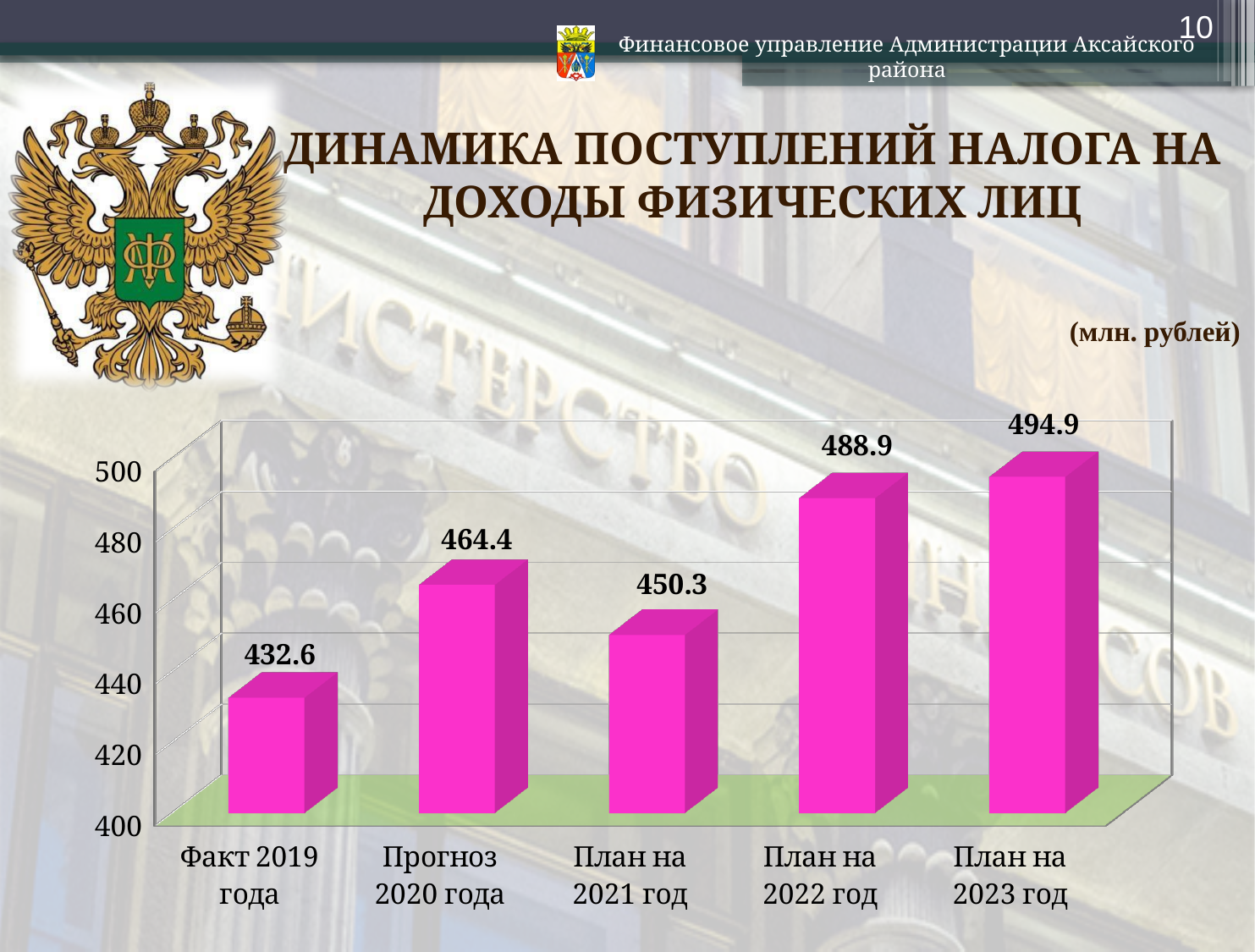
Is the value for План на 2021 год greater or less than 460? less In what units are the chart values given? млн. рублей What kind of chart is shown on the slide? bar chart What is the difference between the values for План на 2023 год and План на 2022 год? 6.0 Which category has the highest value? План на 2023 год What is the difference between the values for Прогноз 2020 года and Факт 2019 года? 31.8 How many categories are shown on the chart? 5 Which category has the lowest value? Факт 2019 года Which is larger, the value for Прогноз 2020 года or the value for План на 2021 год? Прогноз 2020 года What is the value for Факт 2019 года? 432.6 What is the value for Прогноз 2020 года? 464.4 What is the value for План на 2022 год? 488.9